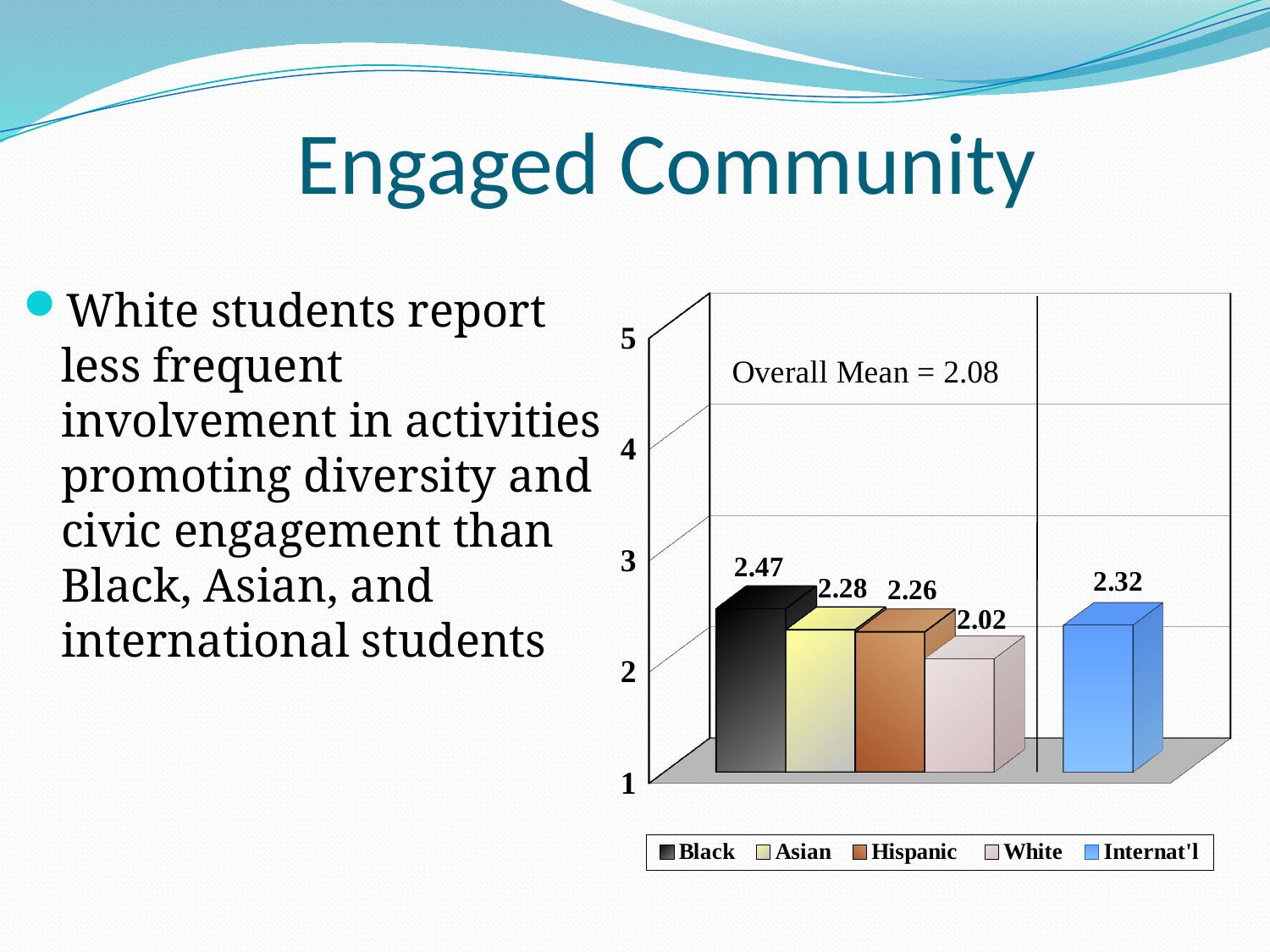
Which is larger, the value for Asian students or the value for Internat'l students? Internat'l Is the value for Hispanic students greater or less than 3? less What is the value for Black students? 2.47 Which group has the highest value? Black How many entries does the legend list? 5 Which group has the lowest value? White What is the value for White students? 2.02 What is the difference between the values for Black and White students? 0.45 What is the value for Internat'l students? 2.32 How many groups are plotted in the chart? 5 What overall mean is stated on the chart? 2.08 What kind of chart is shown on the slide? bar chart